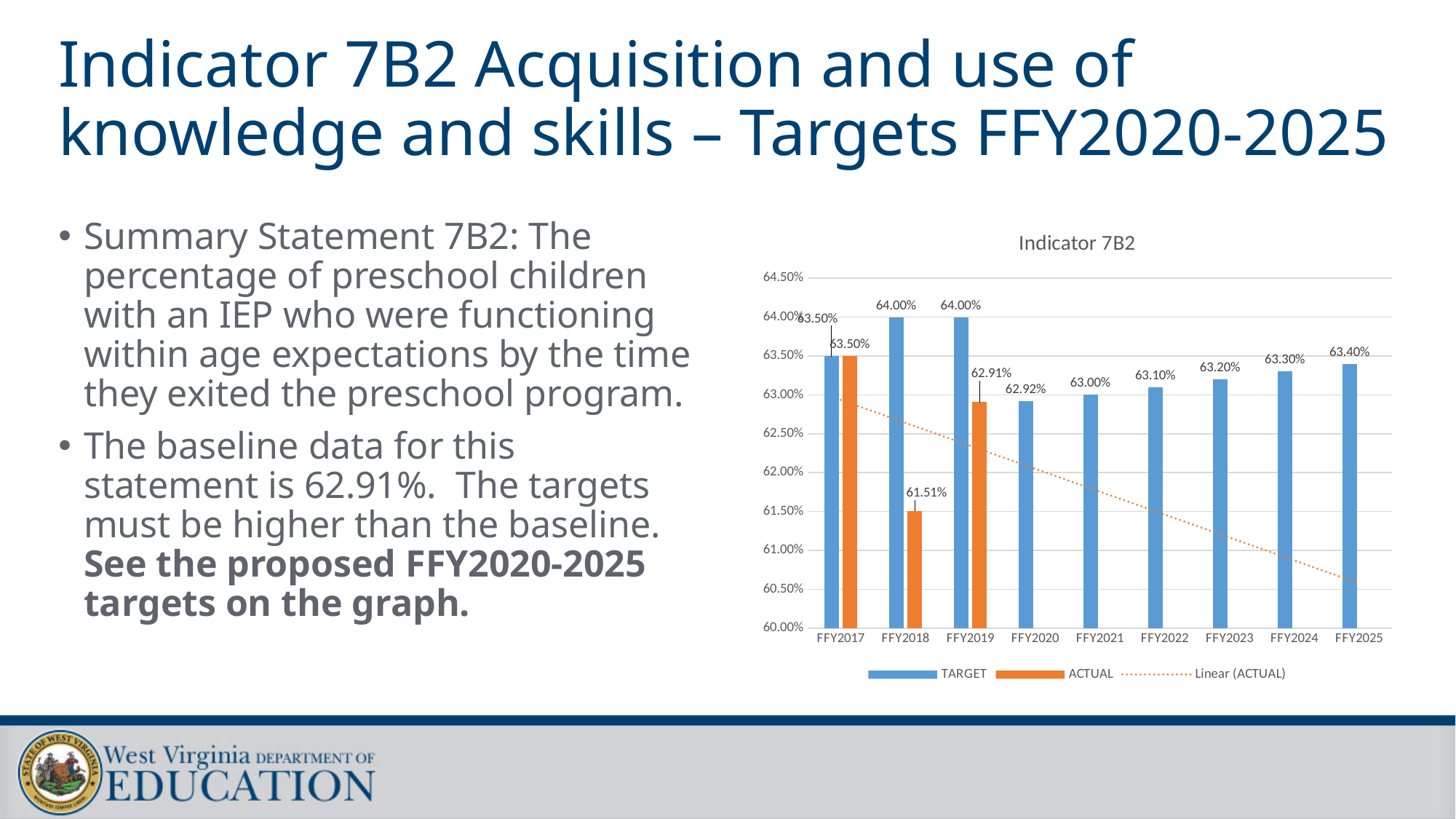
How many years (categories) are shown on the x axis? 9 Do the TARGET values rise or fall from FFY2020 to FFY2025? Rise Which year has the lowest ACTUAL value? FFY2018 What is the TARGET value for FFY2022? 63.10% How many entries does the legend list? 3 What is the highest TARGET value shown on the chart? 64.00% Which is larger: the ACTUAL value for FFY2019 or the TARGET value for FFY2020? TARGET for FFY2020 (62.92%) What is the ACTUAL value for FFY2018? 61.51% What kind of chart is shown on the slide? Bar chart What is the difference between the TARGET and ACTUAL values for FFY2018? 2.49 percentage points What is the ACTUAL value for FFY2019? 62.91% What is the TARGET value for FFY2025? 63.40%